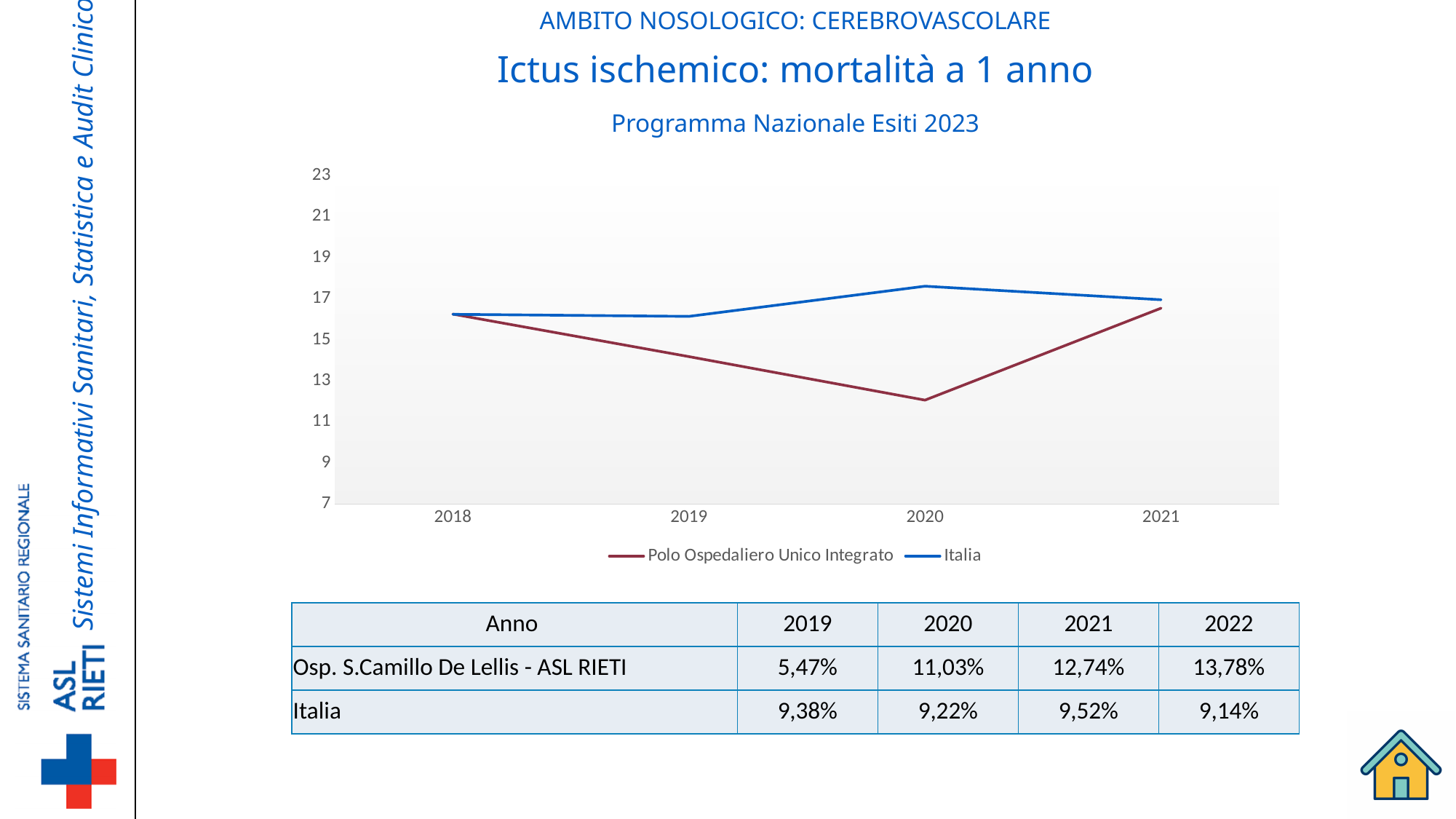
What kind of chart is shown on the slide? line chart Is the value for Polo Ospedaliero Unico Integrato in 2020 greater or less than 13? less Is the value for Polo Ospedaliero Unico Integrato in 2021 greater or less than 15? greater How many years are plotted along the x axis of the chart? 4 In 2020, which series has the higher value, Polo Ospedaliero Unico Integrato or Italia? Italia What colour is the Italia line in the chart? blue Is the value for Polo Ospedaliero Unico Integrato in 2019 greater or less than 15? less In which year does the Polo Ospedaliero Unico Integrato line reach its lowest value? 2020 How many series does the chart legend list? 2 In which year does the Italia line reach its highest value? 2020 Does the Polo Ospedaliero Unico Integrato line rise or fall from 2018 to 2020? fall